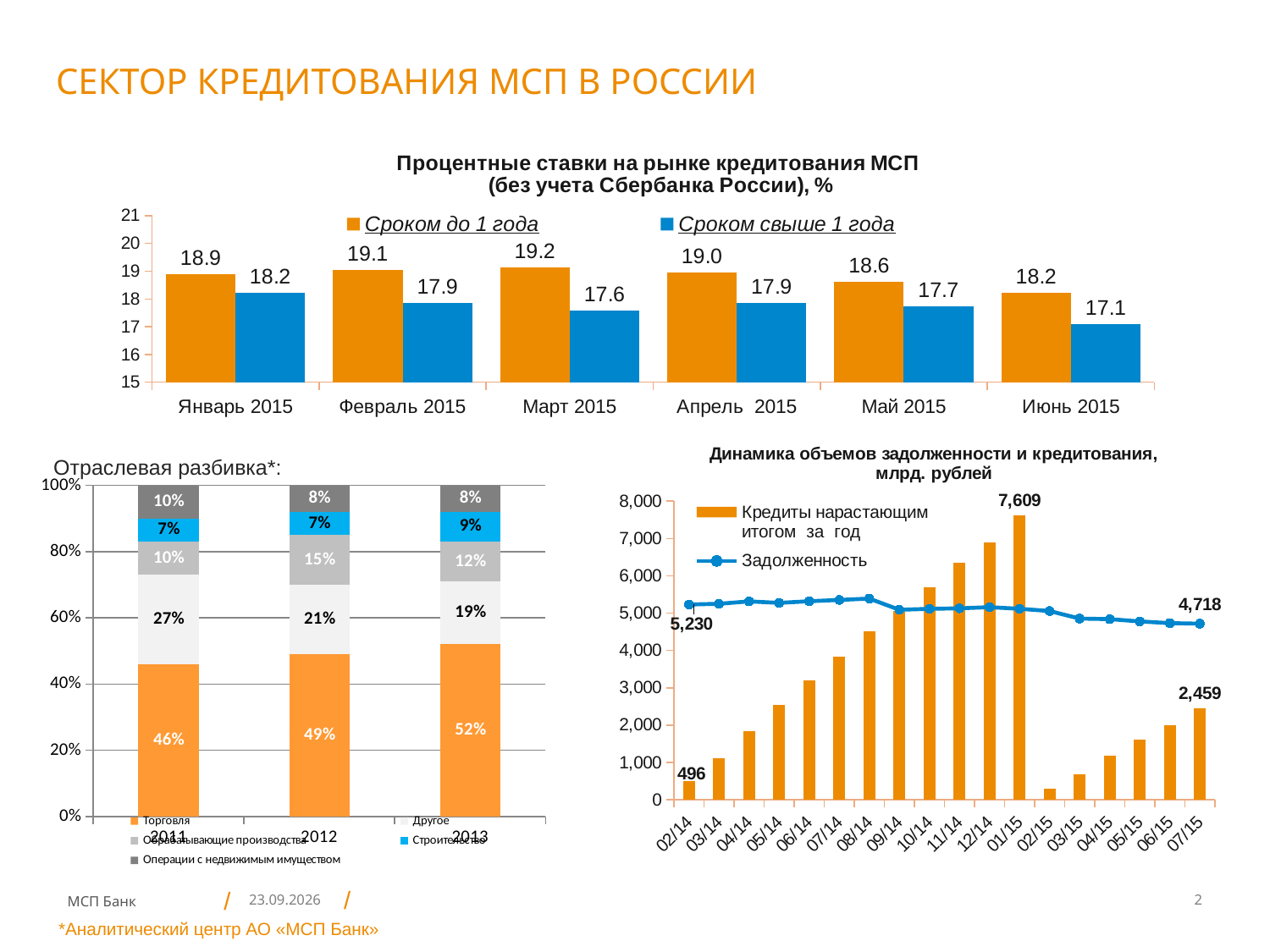
In the chart 'Отраслевая разбивка', which year has the highest share for 'Торговля'? 2013 In the chart 'Отраслевая разбивка', how many years are shown on the x axis? 3 In the chart 'Динамика объемов задолженности и кредитования', what is the labelled value of 'Задолженность' at 07/15? 4,718 In the chart 'Процентные ставки на рынке кредитования МСП', does the value for 'Сроком свыше 1 года' rise or fall from Апрель 2015 to Июнь 2015? fall In the chart 'Динамика объемов задолженности и кредитования', what is the labelled value of 'Кредиты нарастающим итогом за год' for 01/15? 7,609 In the chart 'Динамика объемов задолженности и кредитования', is the bar for 06/15 greater or less than 3,000? less In the chart 'Процентные ставки на рынке кредитования МСП', what is the difference between 'Сроком до 1 года' and 'Сроком свыше 1 года' in Март 2015? 1.6 In the chart 'Процентные ставки на рынке кредитования МСП', what is the value for 'Сроком до 1 года' in Март 2015? 19.2 In the chart 'Процентные ставки на рынке кредитования МСП', which month has the highest value for 'Сроком до 1 года'? Март 2015 In the chart 'Отраслевая разбивка', what is the share of 'Торговля' in 2013? 52% In the chart 'Процентные ставки на рынке кредитования МСП', how many series does the legend list? 2 In the chart 'Процентные ставки на рынке кредитования МСП', what is the value for 'Сроком свыше 1 года' in Июнь 2015? 17.1